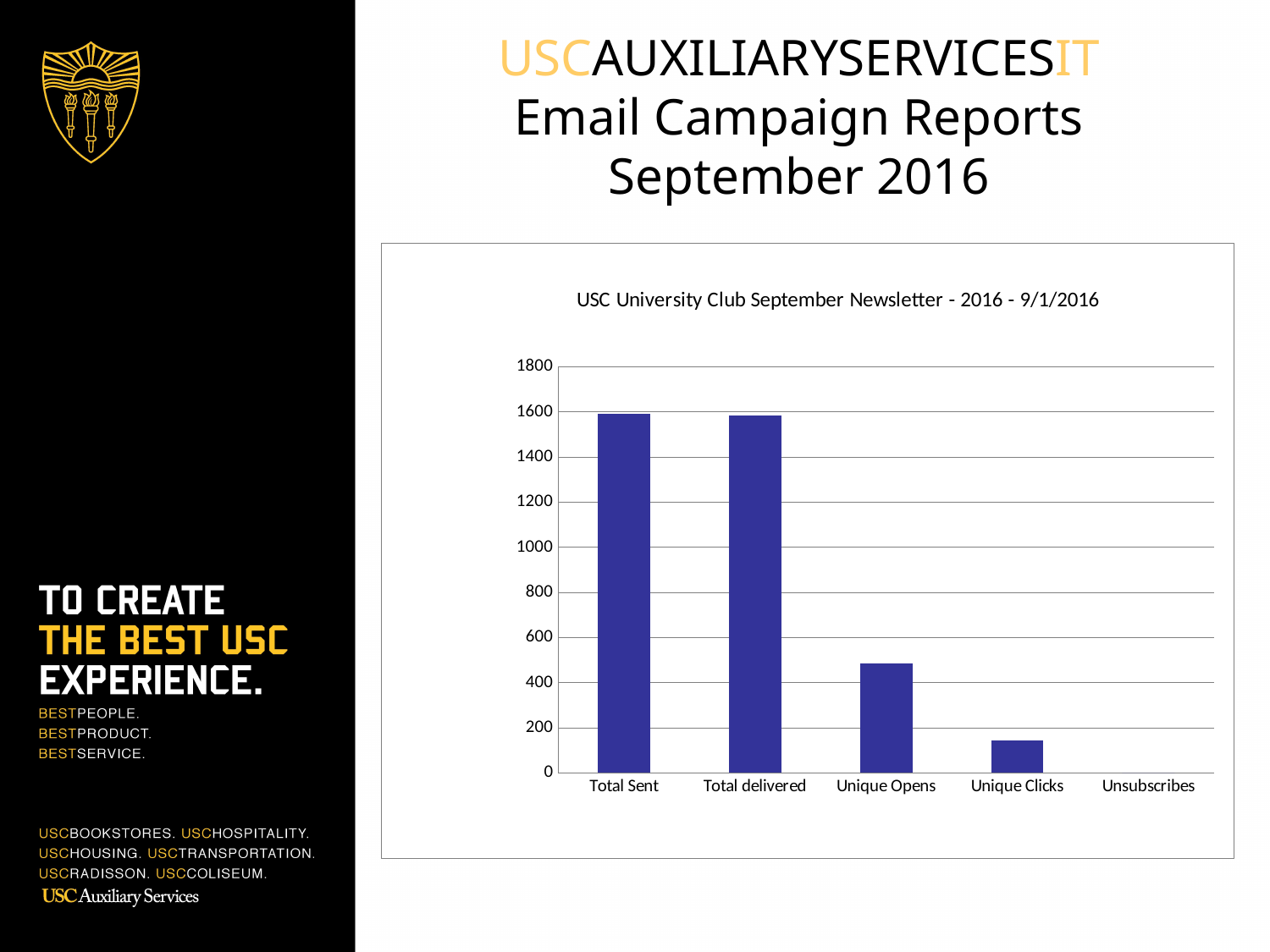
Is the value for Unique Opens greater or less than 400? greater Which is larger, the value for Total delivered or the value for Unique Opens? Total delivered What is the title of the chart? USC University Club September Newsletter - 2016 - 9/1/2016 Is the value for Total Sent greater or less than 1400? greater Which is larger, the value for Unique Opens or the value for Unique Clicks? Unique Opens Which category has the lowest value in the chart? Unsubscribes Is the value for Unique Clicks greater or less than 200? less Do the values generally rise or fall moving from left to right along the x axis? fall How many categories are shown on the x axis of the chart? 5 What kind of chart is shown on the slide? bar chart